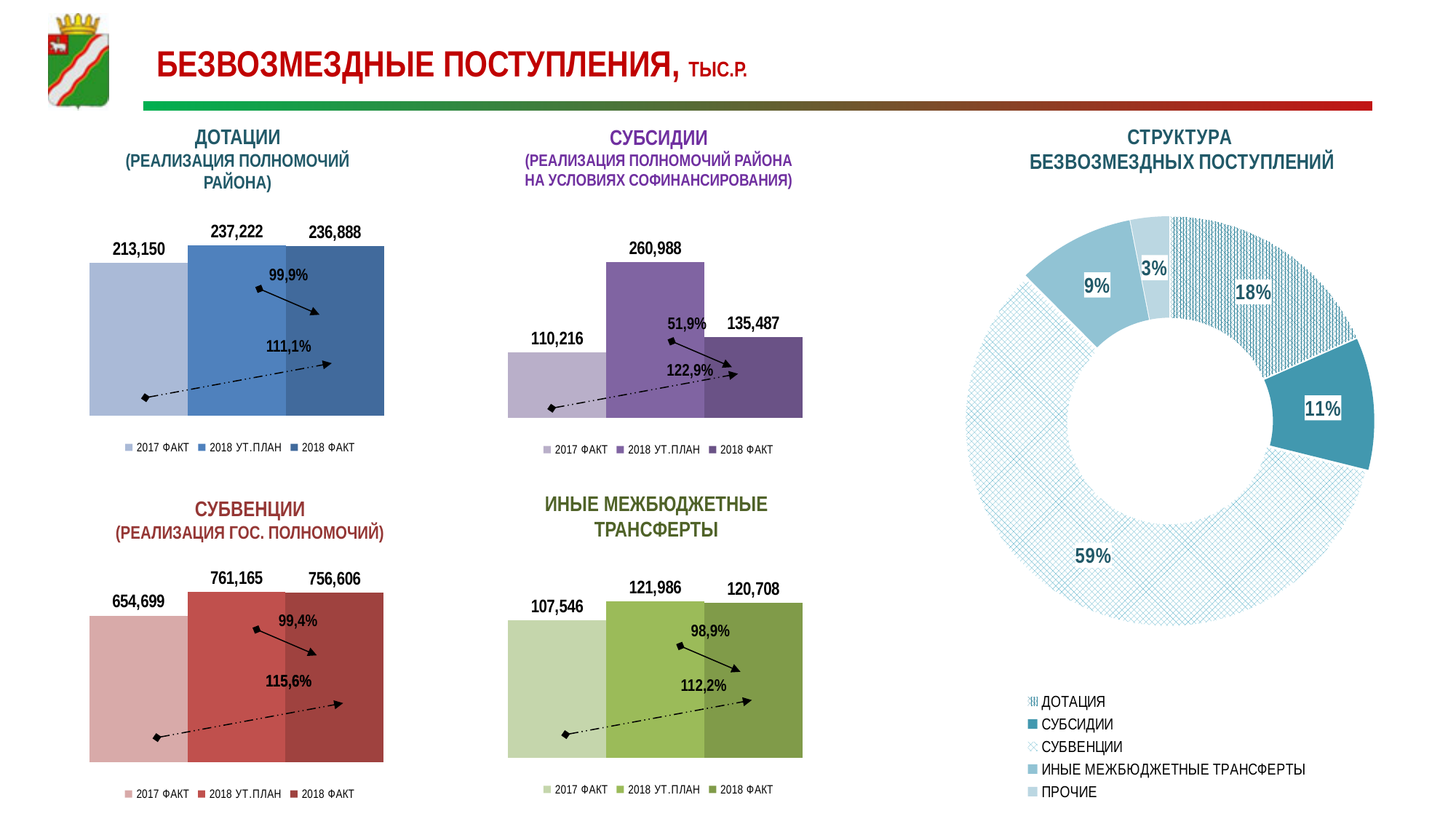
In the СТРУКТУРА БЕЗВОЗМЕЗДНЫХ ПОСТУПЛЕНИЙ chart, what share do СУБВЕНЦИИ have? 59% In the СУБСИДИИ chart, what is the value for 2018 ФАКТ? 135,487 In the ДОТАЦИИ chart, what is the value for 2018 УТ.ПЛАН? 237,222 In the СУБВЕНЦИИ chart, which series has the lowest value? 2017 ФАКТ In the ИНЫЕ МЕЖБЮДЖЕТНЫЕ ТРАНСФЕРТЫ chart, which is larger: 2017 ФАКТ or 2018 ФАКТ? 2018 ФАКТ How many categories does the legend of the СТРУКТУРА БЕЗВОЗМЕЗДНЫХ ПОСТУПЛЕНИЙ chart list? 5 In the СУБСИДИИ chart, what is the difference between 2018 УТ.ПЛАН and 2018 ФАКТ? 125,501 In the ДОТАЦИИ chart, what is the value for 2017 ФАКТ? 213,150 In the СУБСИДИИ chart, which series has the highest value? 2018 УТ.ПЛАН In the СУБВЕНЦИИ chart, what is the value for 2018 ФАКТ? 756,606 In the ИНЫЕ МЕЖБЮДЖЕТНЫЕ ТРАНСФЕРТЫ chart, what is the value for 2018 УТ.ПЛАН? 121,986 What kind of chart is the СТРУКТУРА БЕЗВОЗМЕЗДНЫХ ПОСТУПЛЕНИЙ chart? Pie (donut) chart